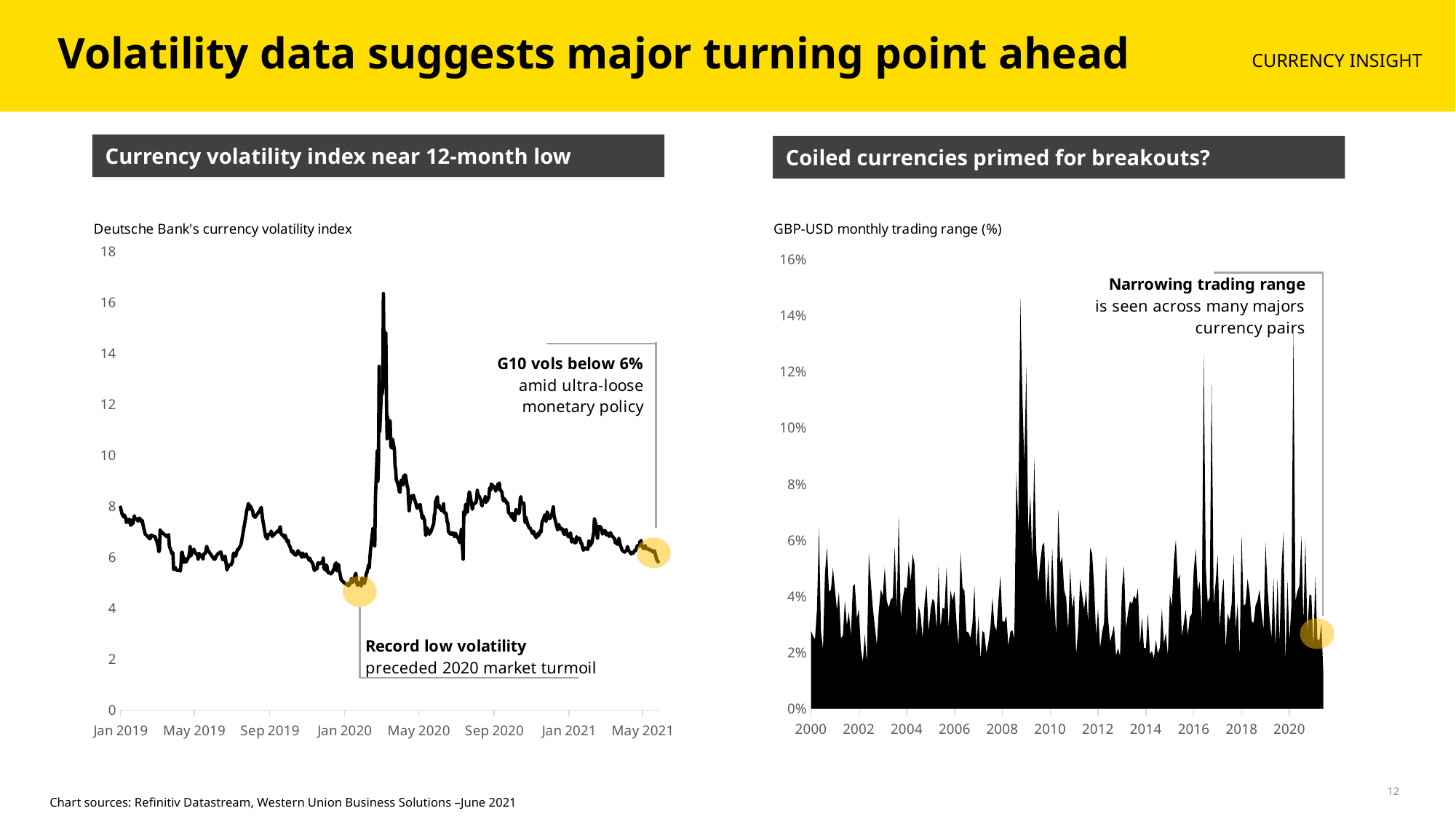
On the left chart, 'Deutsche Bank's currency volatility index', does the index generally rise or fall between Jan 2019 and Jan 2020? fall On the right chart, 'GBP-USD monthly trading range (%)', is the most recent value (highlighted in 2021) greater or less than 4%? less On the right chart, 'GBP-USD monthly trading range (%)', is the highest peak around 2008 greater or less than 12%? greater On the right chart, 'GBP-USD monthly trading range (%)', what is the highest value shown on the vertical axis? 16% On the left chart, 'Deutsche Bank's currency volatility index', is the value at May 2021 greater or less than 8? less What kind of chart is the left chart, 'Deutsche Bank's currency volatility index'? line chart On the right chart, 'GBP-USD monthly trading range (%)', which is larger: the peak around 2008 or the peak around 2016? the peak around 2008 On the left chart, 'Deutsche Bank's currency volatility index', what is the first date label on the horizontal axis? Jan 2019 On the left chart, 'Deutsche Bank's currency volatility index', in which year does the index reach its highest value? 2020 What kind of chart is the right chart, 'GBP-USD monthly trading range (%)'? area chart